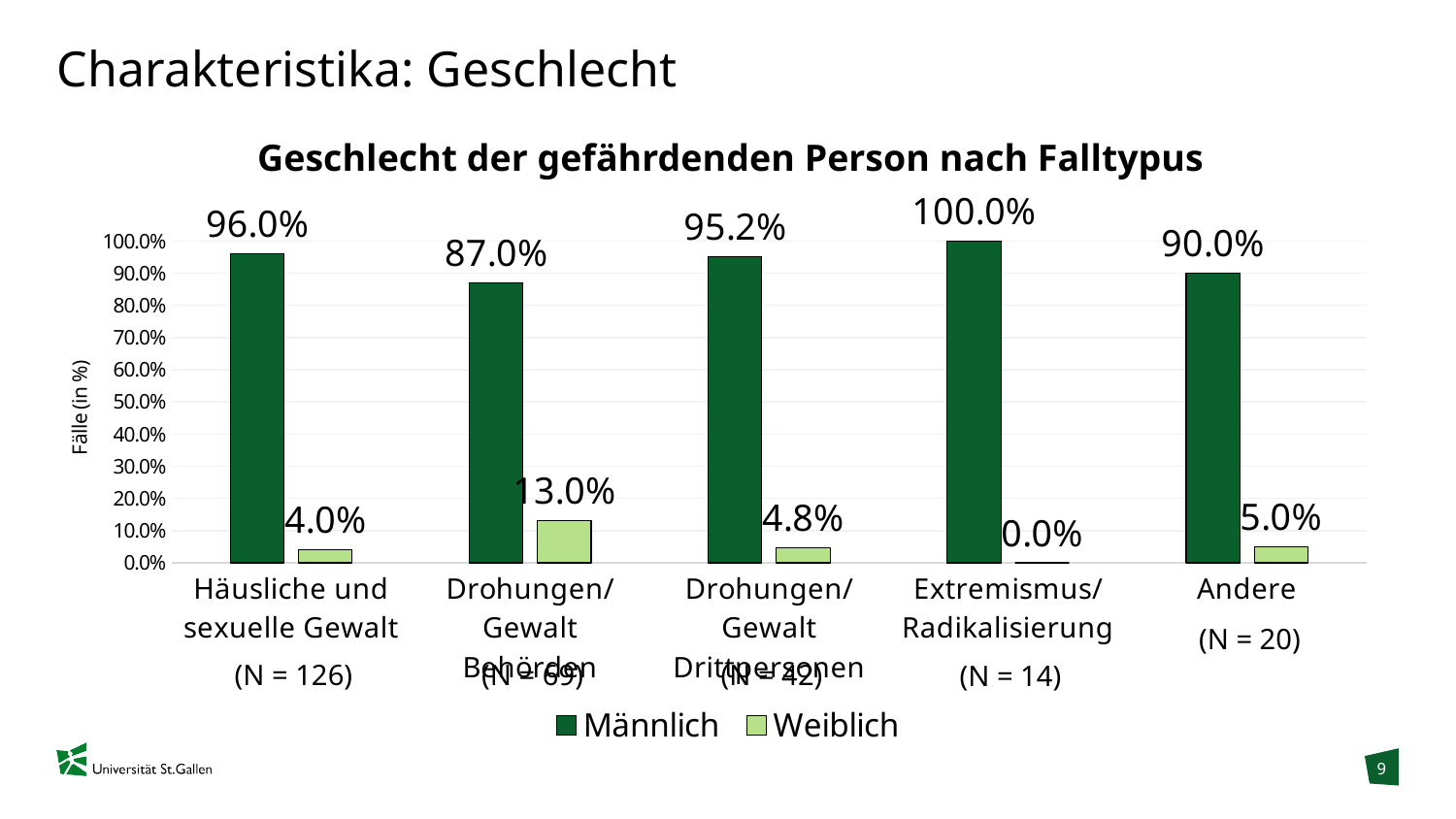
What is the difference between the Männlich values for Häusliche und sexuelle Gewalt and Andere? 6.0% Which category has the highest Weiblich value? Drohungen/Gewalt Behörden What is the Weiblich value for Extremismus/Radikalisierung? 0.0% Which category has the highest Männlich value? Extremismus/Radikalisierung Which category has the lowest Männlich value? Drohungen/Gewalt Behörden How many categories are shown on the x axis? 5 How many series does the legend list? 2 What is the Weiblich value for Drohungen/Gewalt Behörden? 13.0% What type of chart is shown on the slide? bar chart What is the Männlich value for Häusliche und sexuelle Gewalt? 96.0% What is the Männlich value for Drohungen/Gewalt Drittpersonen? 95.2% Is the Weiblich value for Andere larger or smaller than the Weiblich value for Drohungen/Gewalt Drittpersonen? larger